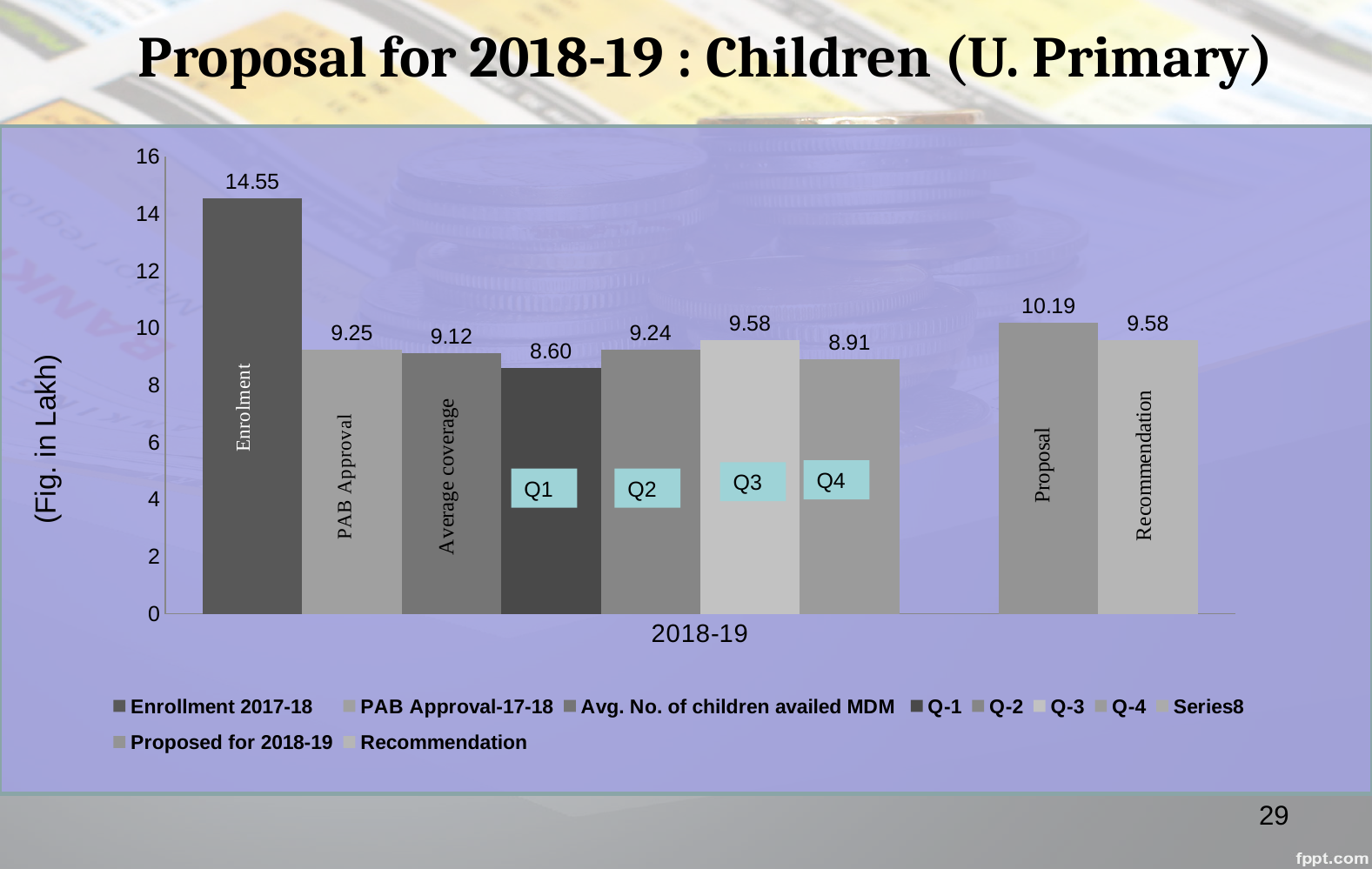
What type of chart is shown on the slide? Bar chart Which of the four quarterly bars (Q1–Q4) has the lowest value? Q1 What is the value shown for the Proposal bar? 10.19 Which is larger, the Q2 value or the Q4 value? Q2 What is the value of the Average coverage bar? 9.12 What is the difference between the Enrolment value and the PAB Approval value? 5.30 What is the label on the vertical axis? (Fig. in Lakh) What value is labelled on the Q3 bar? 9.58 What is the value of the Enrolment bar? 14.55 How many series does the legend list? 10 Which bar has the highest value? Enrolment What is the difference between the Proposal value and the Recommendation value? 0.61